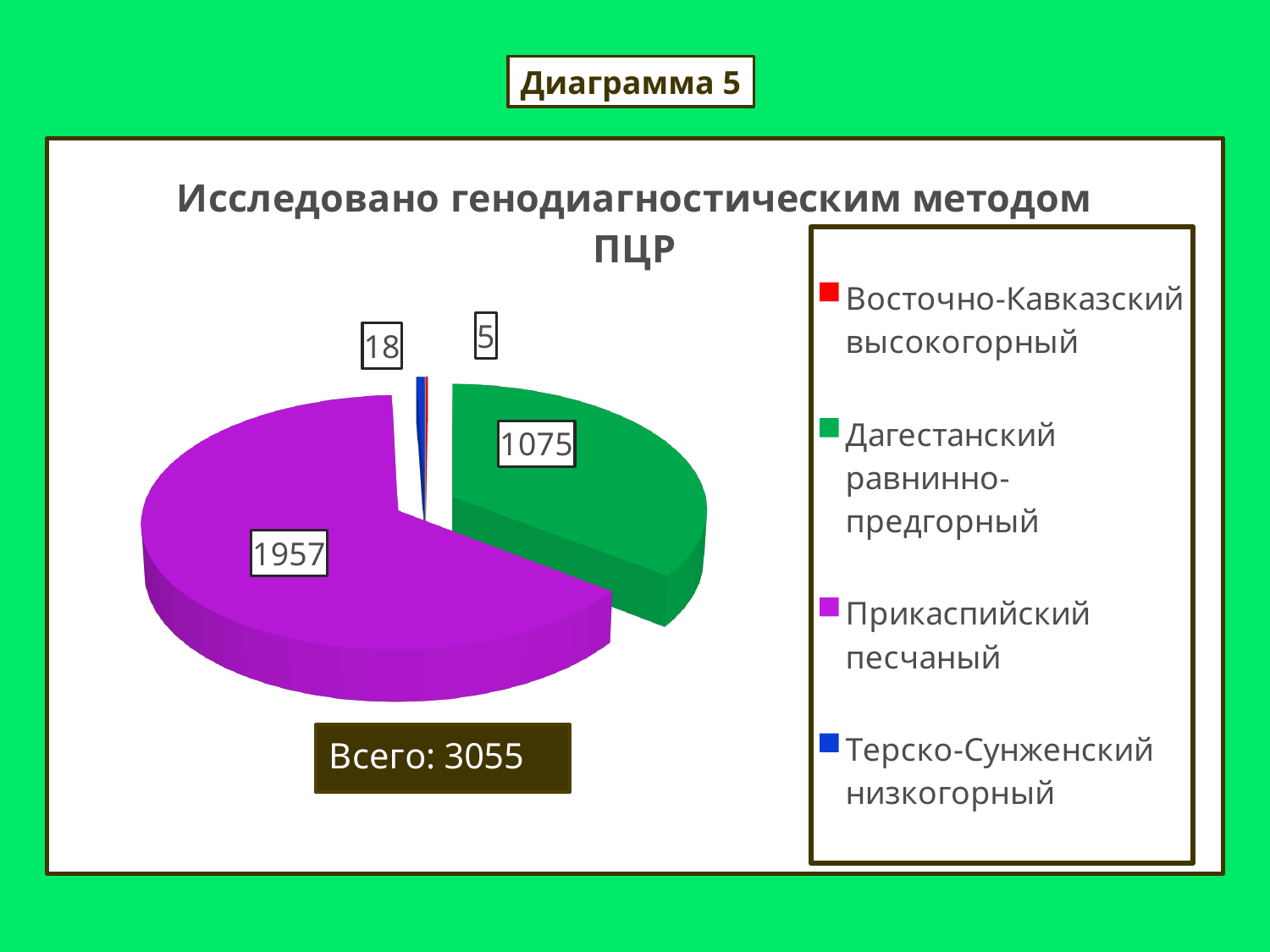
What is the difference between the values for Прикаспийский песчаный and Дагестанский равнинно-предгорный? 882 Which category has the smallest slice of the pie? Восточно-Кавказский высокогорный What is the value for Терско-Сунженский низкогорный? 18 What total is shown below the pie chart? Всего: 3055 What is the value for Восточно-Кавказский высокогорный? 5 Which category has the largest slice of the pie? Прикаспийский песчаный How many categories does the pie chart have? 4 What is the value for Дагестанский равнинно-предгорный? 1075 What is the title of the chart? Исследовано генодиагностическим методом ПЦР What is the value for Прикаспийский песчаный? 1957 What type of chart is shown on the slide? pie chart Which is larger, the value for Терско-Сунженский низкогорный or Восточно-Кавказский высокогорный? Терско-Сунженский низкогорный